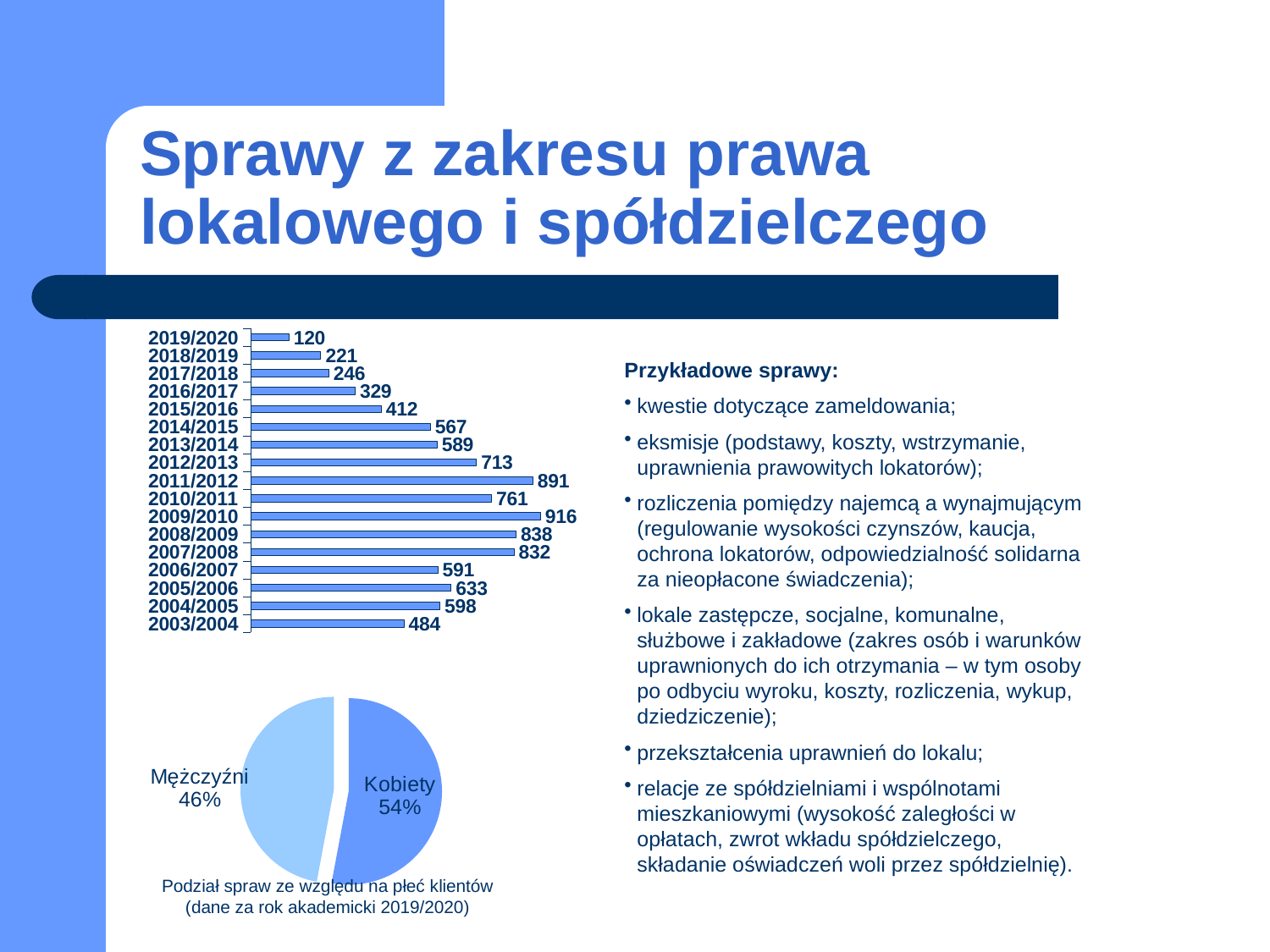
In the pie chart, what share is labelled Mężczyźni? 46% How many academic years are shown in the bar chart? 17 In the bar chart, which academic year has the highest value? 2009/2010 What kind of chart is the chart at the top left of the slide? bar chart In the bar chart, what is the value for 2019/2020? 120 In the bar chart, which academic year has the lowest value? 2019/2020 In the bar chart, what is the value for 2009/2010? 916 In the bar chart, what is the difference between the values for 2011/2012 and 2010/2011? 130 In the pie chart, what share is labelled Kobiety? 54% In the bar chart, what is the value for 2003/2004? 484 In the bar chart, which is larger, the value for 2008/2009 or the value for 2007/2008? 2008/2009 What kind of chart is the chart at the bottom left of the slide? pie chart